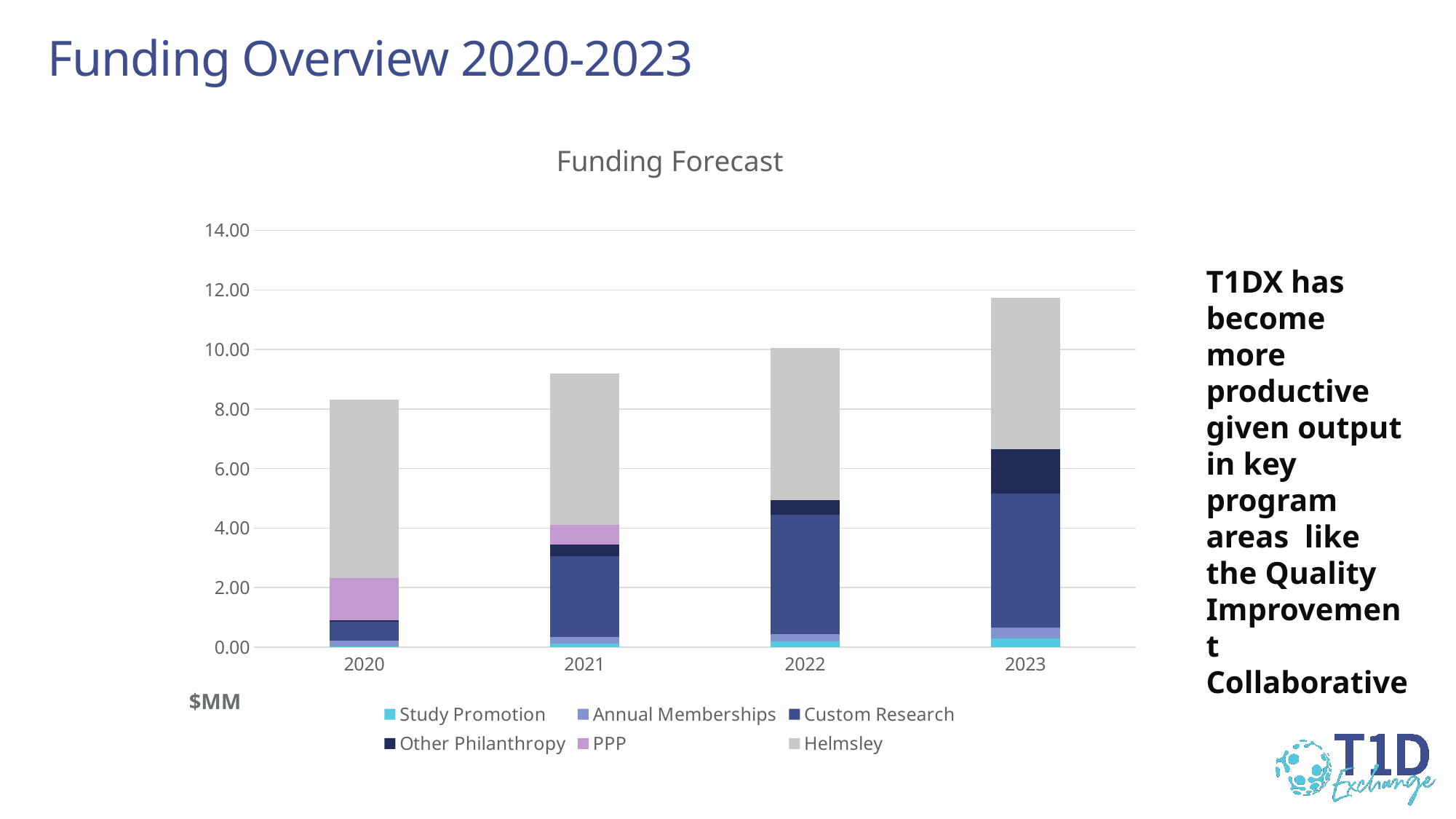
Is the total funding bar for 2023 greater or less than 10.00? greater What kind of chart is shown on the slide? Stacked bar chart Is the total funding bar for 2020 greater or less than 10.00? less Which year has the highest total funding bar? 2023 What is the title of the chart? Funding Forecast How many series does the legend list? 6 Is the total funding bar for 2021 greater or less than 8.00? greater Which year has the lowest total funding bar? 2020 What unit label is shown below the y axis of the chart? $MM Do the total funding bars rise or fall from 2020 to 2023? Rise How many years are shown on the x axis of the chart? 4 Which year has the larger total funding bar, 2021 or 2022? 2022